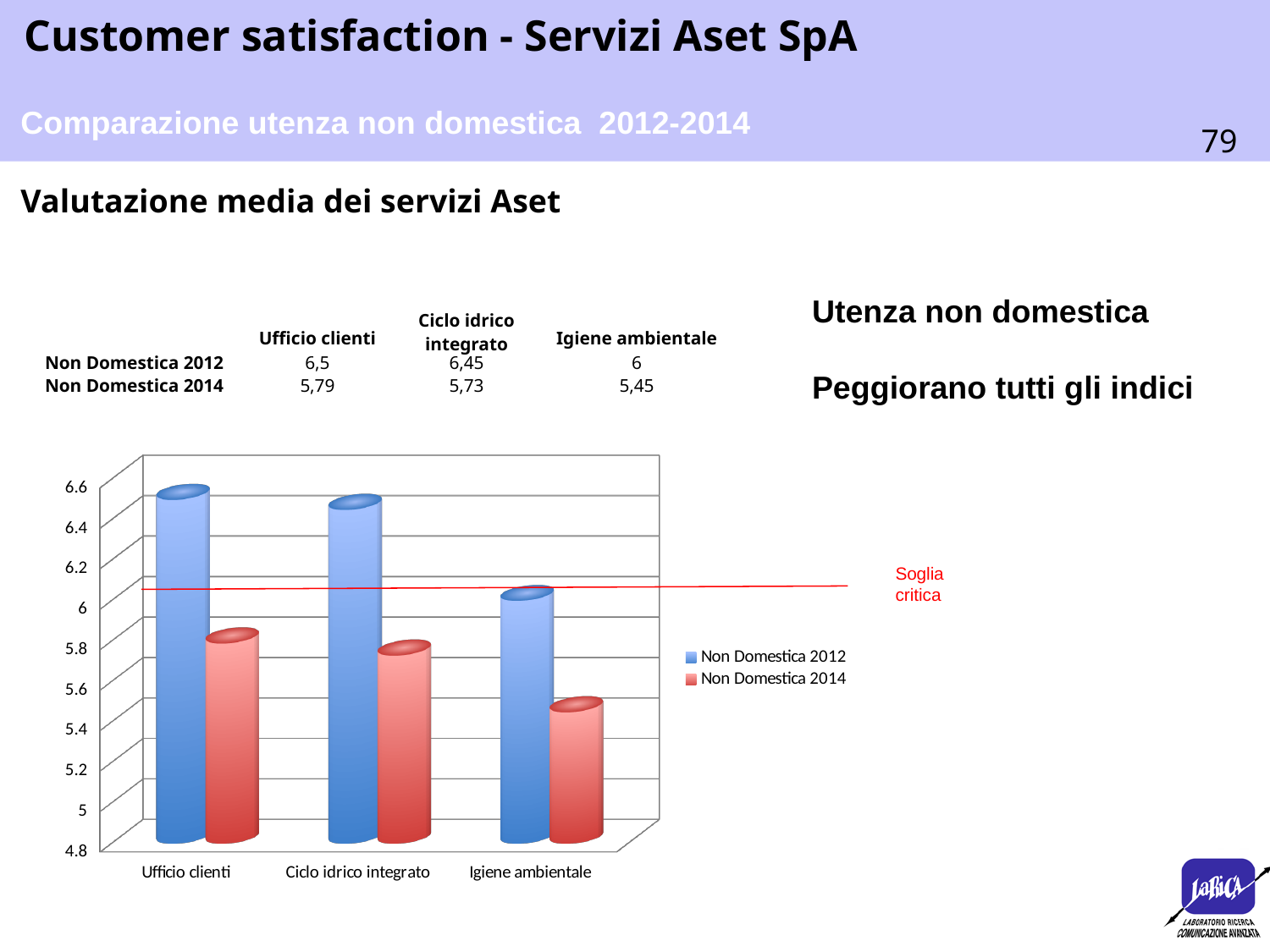
What is the value for Igiene ambientale in the Non Domestica 2014 series? 5,45 What is the difference between the Non Domestica 2012 and Non Domestica 2014 values for Ufficio clienti? 0,71 How many series does the chart legend list? 2 How many categories are shown on the x axis of the chart? 3 Which category has the highest value in the Non Domestica 2012 series? Ufficio clienti Which category has the lowest value in the Non Domestica 2014 series? Igiene ambientale What is the value for Ufficio clienti in the Non Domestica 2012 series? 6,5 Which is larger for Ciclo idrico integrato: the Non Domestica 2012 value or the Non Domestica 2014 value? Non Domestica 2012 What kind of chart is shown on the slide? bar chart What is the difference between the Non Domestica 2012 and Non Domestica 2014 values for Igiene ambientale? 0,55 What is the value for Ciclo idrico integrato in the Non Domestica 2014 series? 5,73 Is the Non Domestica 2014 value for Igiene ambientale greater or less than 5.6? less